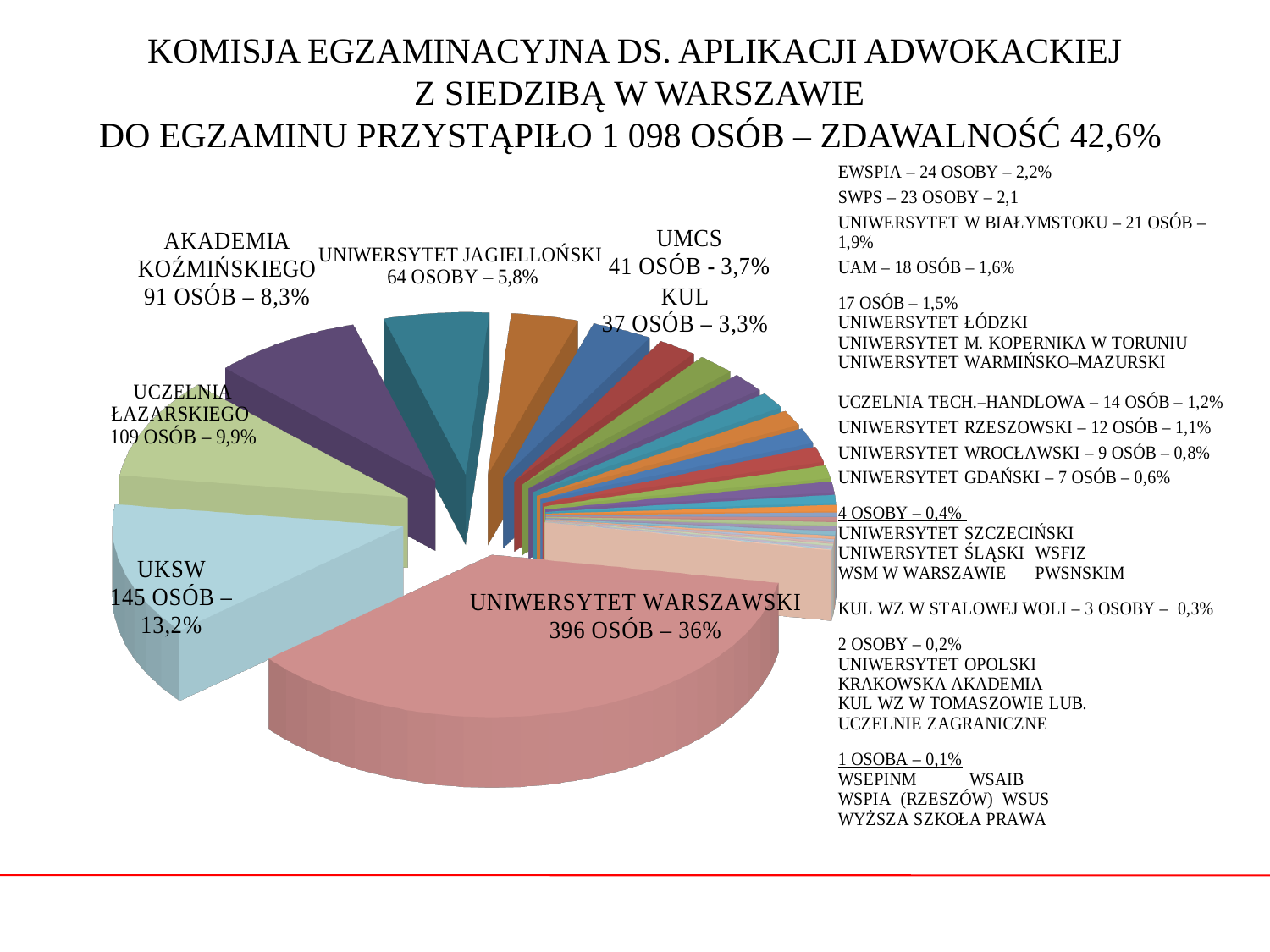
Which has more people, UKSW or UCZELNIA ŁAZARSKIEGO? UKSW What is the difference in number of people between UNIWERSYTET WARSZAWSKI and UKSW? 251 How many people from UNIWERSYTET WARSZAWSKI took the exam according to the chart? 396 OSÓB Which university has the largest slice of the pie chart? UNIWERSYTET WARSZAWSKI What share of the pie does UKSW represent? 13,2% What percentage is shown for AKADEMIA KOŹMIŃSKIEGO? 8,3% How many people from UCZELNIA ŁAZARSKIEGO are shown on the chart? 109 OSÓB What pass rate (zdawalność) is given in the slide title? 42,6% What kind of chart is shown on the slide? pie chart According to the slide title, how many people took the exam in total? 1 098 OSÓB How many people from UNIWERSYTET JAGIELLOŃSKI are shown on the chart? 64 OSOBY What is the difference in number of people between UMCS and KUL? 4